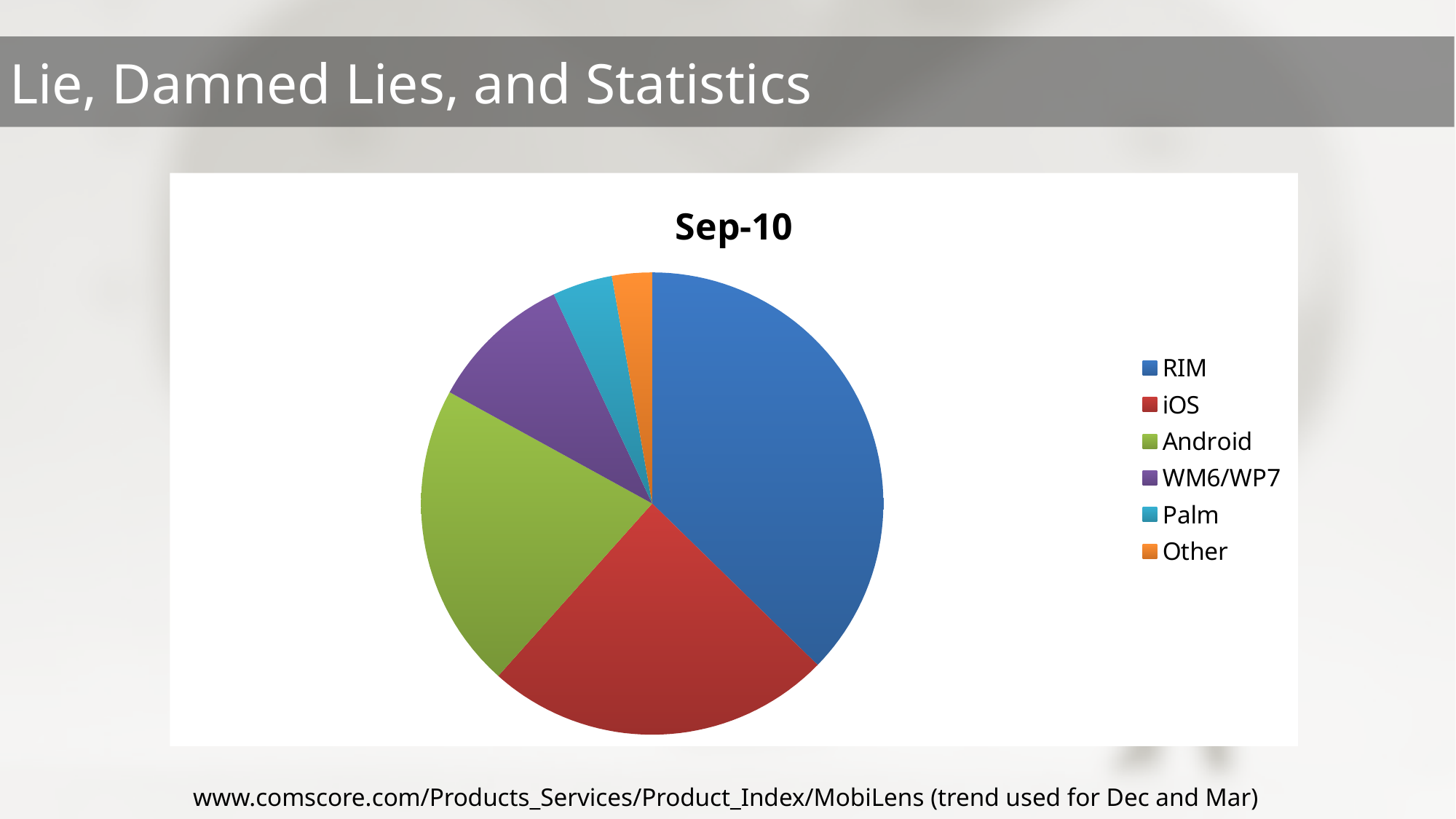
Which category is shown in green in the pie chart? Android What is the title of the chart? Sep-10 Which slice is larger, Android or WM6/WP7? Android What kind of chart is shown on the slide? pie chart Which slice is larger, iOS or Palm? iOS Which slice is larger, WM6/WP7 or Other? WM6/WP7 Which category has the largest slice of the pie? RIM How many categories does the pie chart have? 6